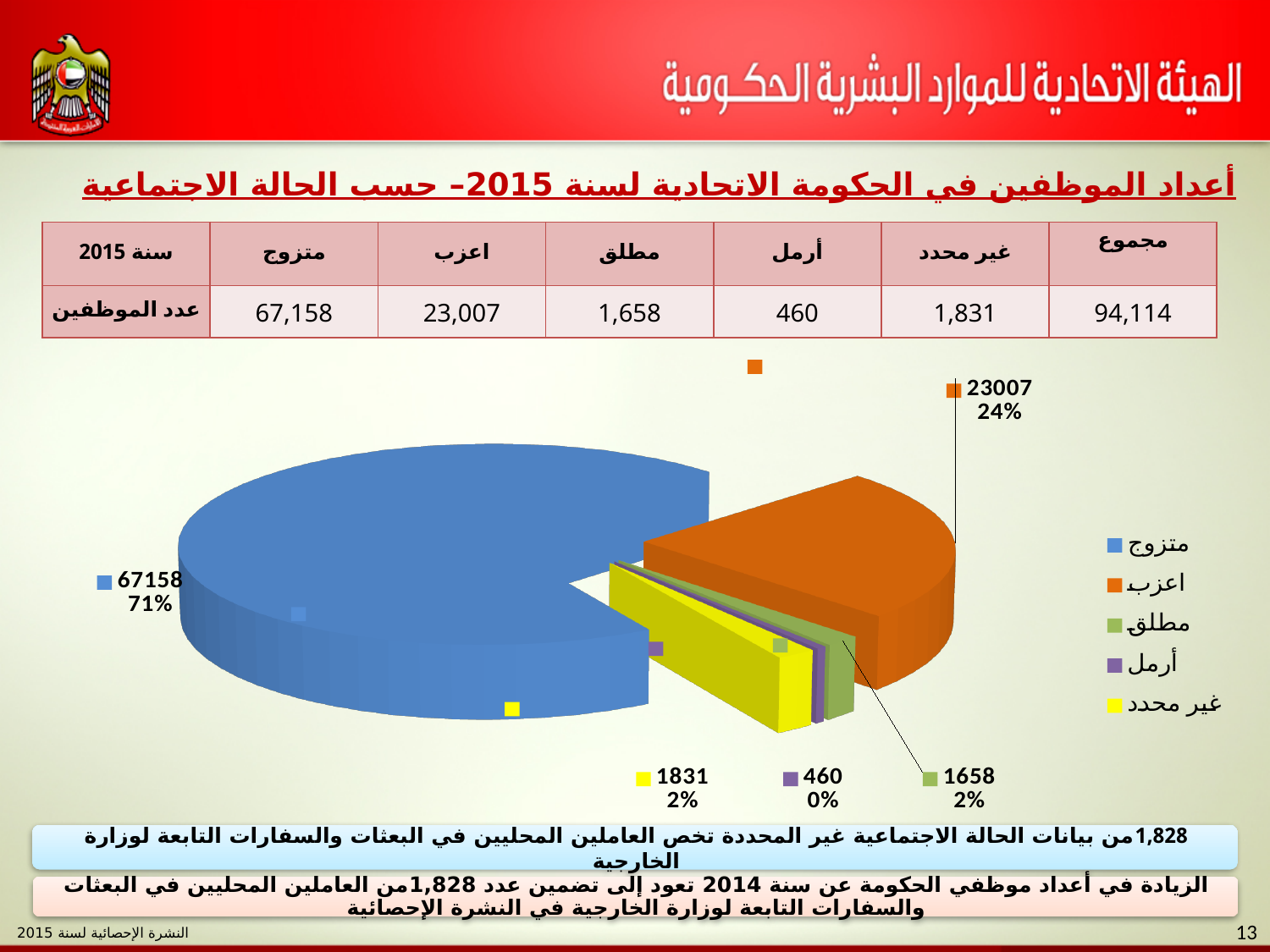
Which category has the smallest slice in the pie chart? أرمل What colour is the slice for متزوج in the pie chart? blue Which category has the largest slice in the pie chart? متزوج What kind of chart is shown on the slide? pie chart What percentage share does the pie chart show for اعزب? 24% What is the difference between the values for متزوج and اعزب in the pie chart? 44151 What value is shown on the pie chart for متزوج? 67158 How many categories does the legend of the pie chart list? 5 Which is larger in the pie chart, the value for غير محدد or the value for مطلق? غير محدد What percentage share does the pie chart show for متزوج? 71% What value is shown on the pie chart for غير محدد? 1831 What value is shown on the pie chart for أرمل? 460